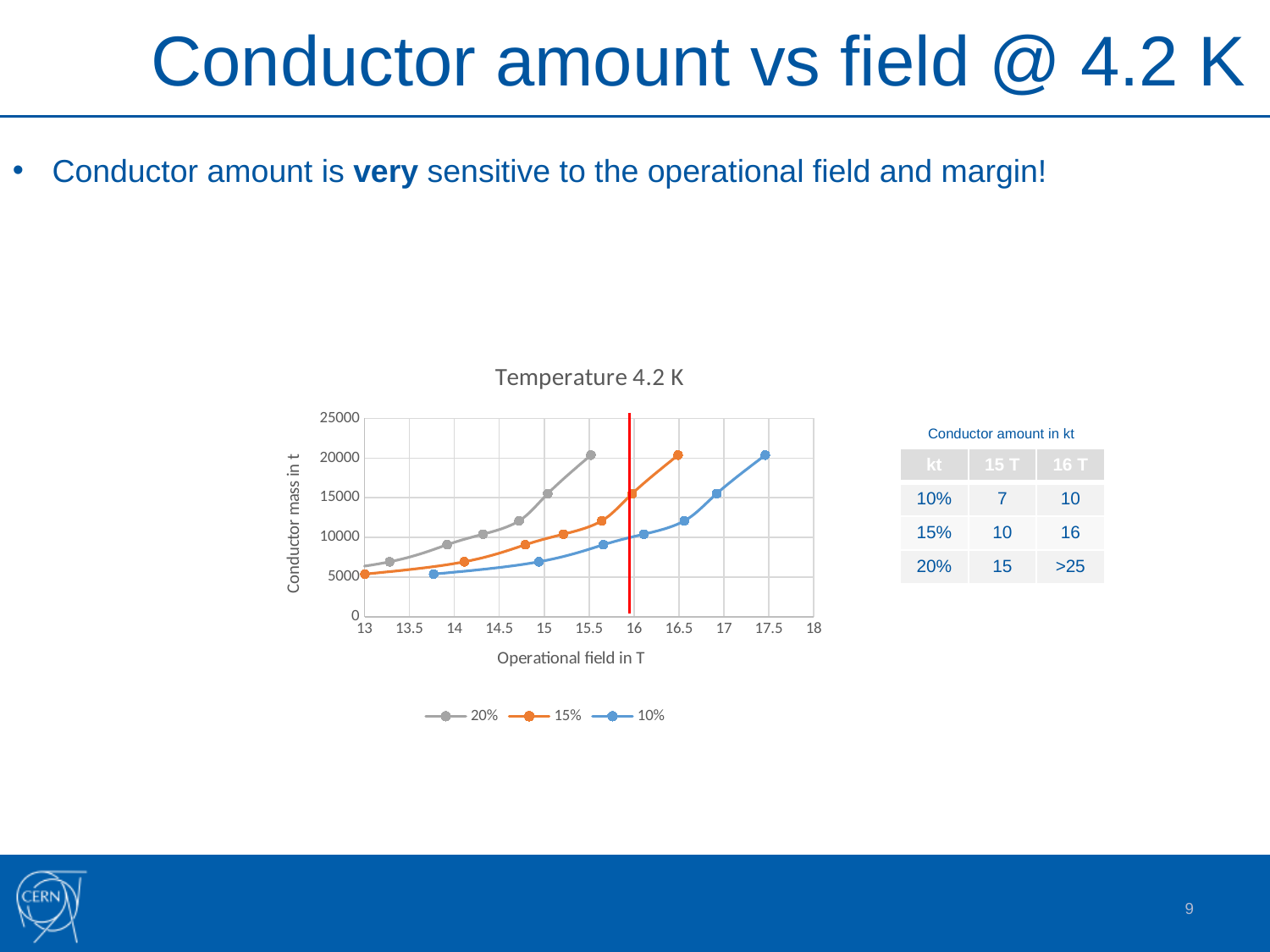
What is the title of the chart? Temperature 4.2 K Is the conductor mass for the 20% series at 14 T greater or less than 10000? less How many series does the chart legend list? 3 At an operational field of 15 T, which series has the higher conductor mass, 20% or 10%? 20% Does the conductor mass for the 10% series rise or fall as the operational field increases? rise What is the label of the x axis of the chart? Operational field in T What kind of chart is shown on the slide? line chart At an operational field of 15.5 T, which series has the highest conductor mass? 20% Is the conductor mass for the 15% series at 16.5 T greater or less than 15000? greater Does the conductor mass for the 20% series rise or fall as the operational field increases? rise Is the conductor mass for the 20% series at 13 T greater or less than 5000? greater